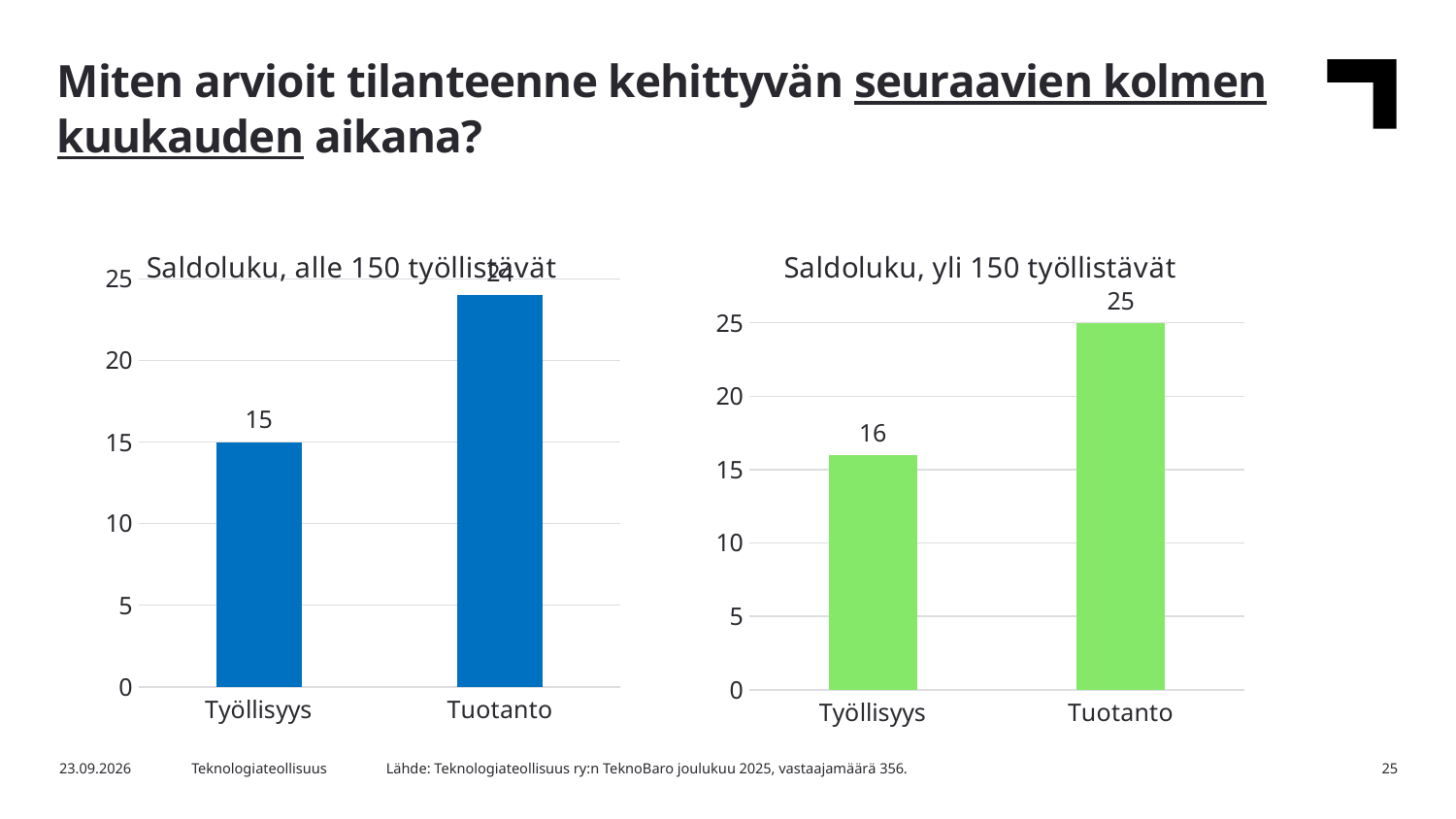
In the chart titled 'Saldoluku, alle 150 työllistävät', what is the value for Työllisyys? 15 In the chart titled 'Saldoluku, yli 150 työllistävät', what is the value for Tuotanto? 25 In the chart titled 'Saldoluku, yli 150 työllistävät', what is the value for Työllisyys? 16 In the chart titled 'Saldoluku, alle 150 työllistävät', is the value for Tuotanto greater or less than 20? greater How many categories are shown in the chart titled 'Saldoluku, yli 150 työllistävät'? 2 In the chart titled 'Saldoluku, alle 150 työllistävät', which is larger, the value for Työllisyys or the value for Tuotanto? Tuotanto What kind of chart is the chart on the left of the slide? Bar chart What is the title of the chart on the right of the slide? Saldoluku, yli 150 työllistävät In the chart titled 'Saldoluku, alle 150 työllistävät', which category has the lowest value? Työllisyys In the chart titled 'Saldoluku, yli 150 työllistävät', is the value for Työllisyys greater or less than 20? less In the chart titled 'Saldoluku, yli 150 työllistävät', what is the difference between the values for Tuotanto and Työllisyys? 9 In the chart titled 'Saldoluku, yli 150 työllistävät', which category has the highest value? Tuotanto